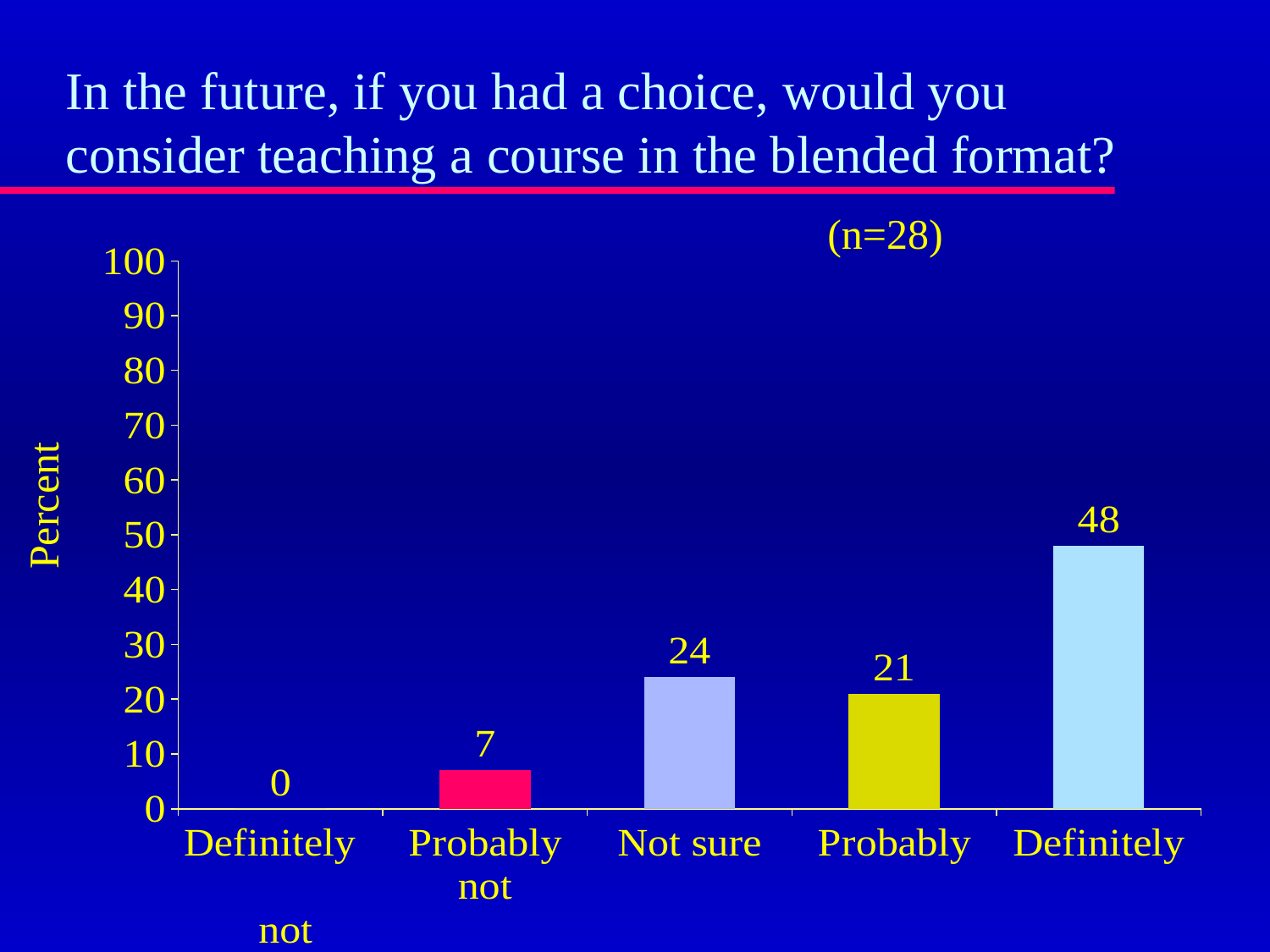
What kind of chart is shown on the slide? bar chart What is the value for "Probably not"? 7 Which category has the lowest value? Definitely not Is the value for "Definitely" greater or less than 40? greater How many categories are shown on the x axis? 5 What is the value for "Probably"? 21 What is the value for "Definitely"? 48 What is the value for "Not sure"? 24 What is the label of the y axis? Percent Which is larger, the value for "Not sure" or the value for "Probably"? Not sure What is the difference between the values for "Definitely" and "Not sure"? 24 Which category has the highest value? Definitely